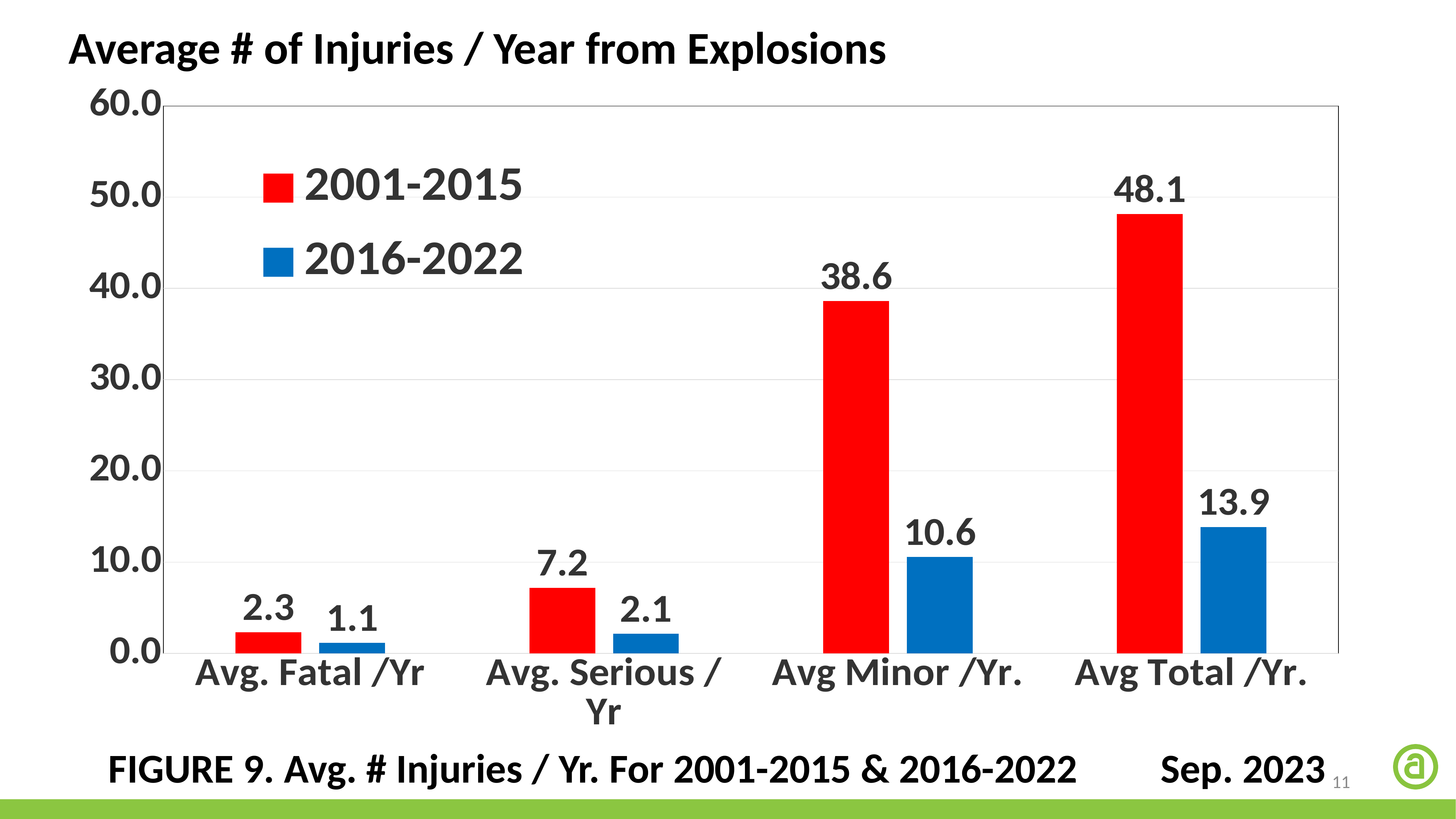
Is the 2016-2022 value for Avg Total /Yr. greater or less than 20.0? less What is the value for Avg. Serious / Yr in the 2016-2022 series? 2.1 What is the value for Avg Total /Yr. in the 2001-2015 series? 48.1 What kind of chart is shown on the slide? bar chart How many categories are shown on the x axis? 4 Which is larger for Avg. Serious / Yr: the 2001-2015 value or the 2016-2022 value? 2001-2015 How many series does the legend list? 2 Which category has the highest value in the 2001-2015 series? Avg Total /Yr. Which category has the lowest value in the 2016-2022 series? Avg. Fatal /Yr What is the value for Avg. Fatal /Yr in the 2001-2015 series? 2.3 What is the value for Avg Minor /Yr. in the 2016-2022 series? 10.6 What is the difference between the 2001-2015 and 2016-2022 values for Avg Minor /Yr.? 28.0